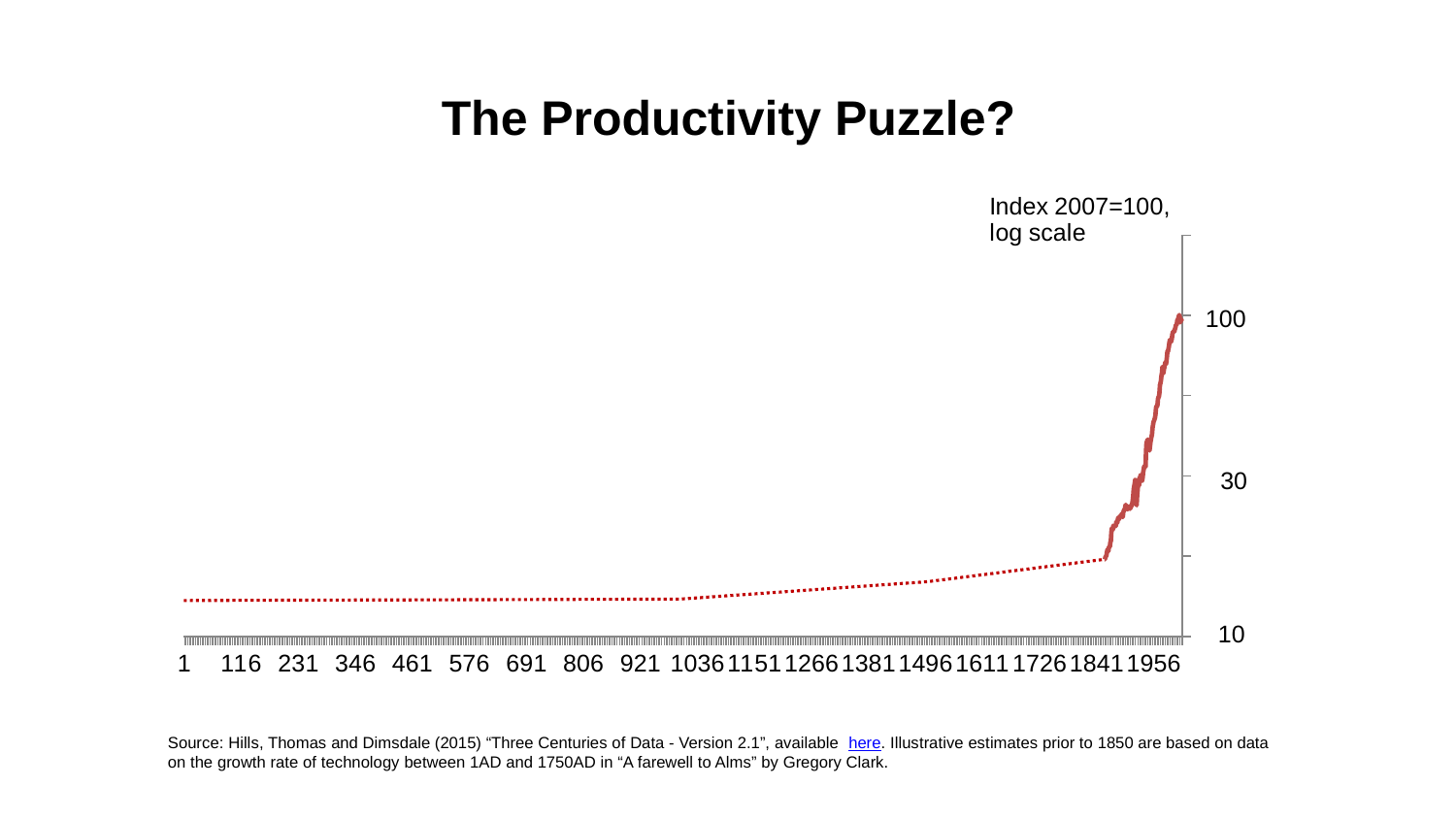
Is the value at year 1841 greater or less than 30? less How many year labels are printed along the x axis? 18 Is the value at year 1 greater or less than 10? greater Do the values generally rise or fall moving from left to right along the x axis? rise Is the value at year 1956 greater or less than 30? greater Which is larger, the value at year 1 or the value at year 1956? 1956 What does the label above the y axis say the index is based on? Index 2007=100, log scale What is the title of the slide's chart? The Productivity Puzzle? Does the line reach its highest value at the left end or the right end of the x axis? right end What kind of chart is shown on the slide? line chart